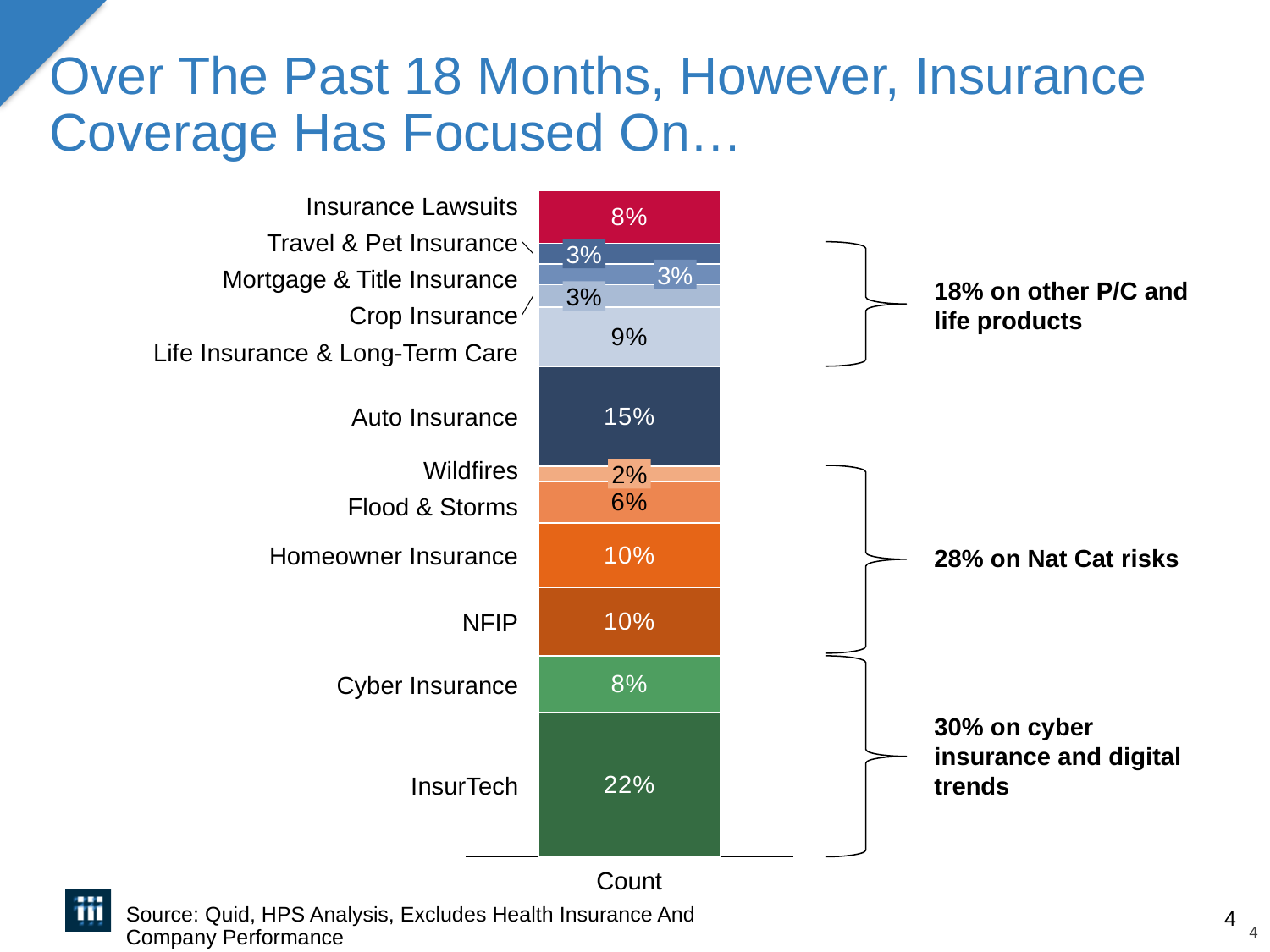
Which category has the largest share of coverage in the chart? InsurTech What percentage is shown for Life Insurance & Long-Term Care? 9% What is the difference between Cyber Insurance and Wildfires? 6 percentage points What is the value for Flood & Storms? 6% What kind of chart is shown on the slide? Stacked bar chart Which is larger, Auto Insurance or Homeowner Insurance? Auto Insurance How many categories are stacked in the bar? 12 What percentage of coverage does the chart show for InsurTech? 22% According to the annotation, what share of coverage was on Nat Cat risks? 28% How many percentage points larger is InsurTech than Auto Insurance? 7 percentage points Which category has the smallest share of coverage in the chart? Wildfires What is the value shown for Auto Insurance? 15%